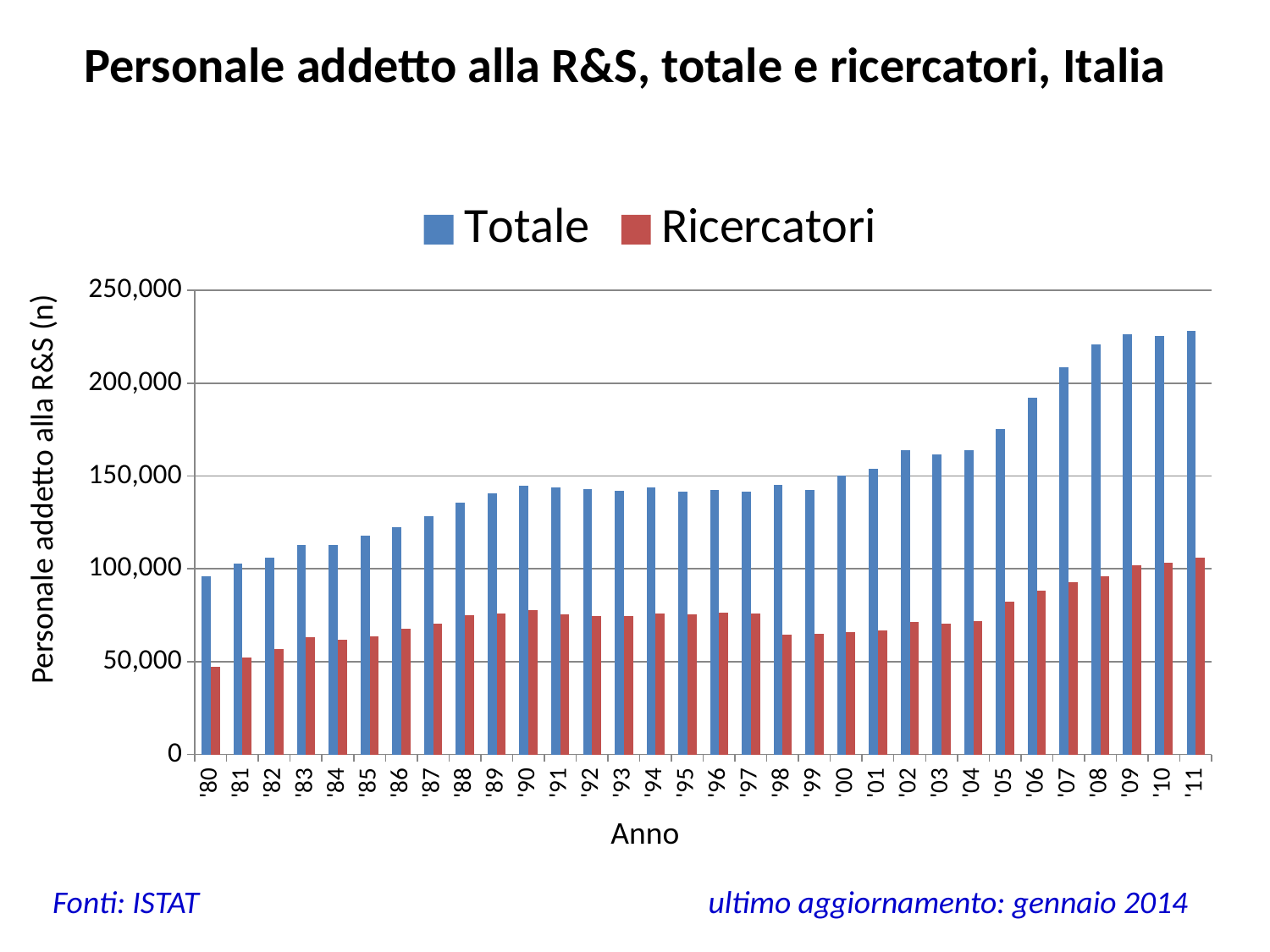
Is the value for Totale in '85 greater or less than 100,000? greater Which year has the lowest value for Ricercatori? '80 Does the Totale series generally rise or fall from '80 to '11? rise Is the value for Totale in '06 greater or less than 150,000? greater Which is larger, the Totale value in '90 or the Totale value in '80? '90 Is the value for Ricercatori in '90 greater or less than 50,000? greater Which year has the lowest value for Totale? '80 How many series does the legend list? 2 How many years are shown on the x axis? 32 What kind of chart is shown on the slide? bar chart